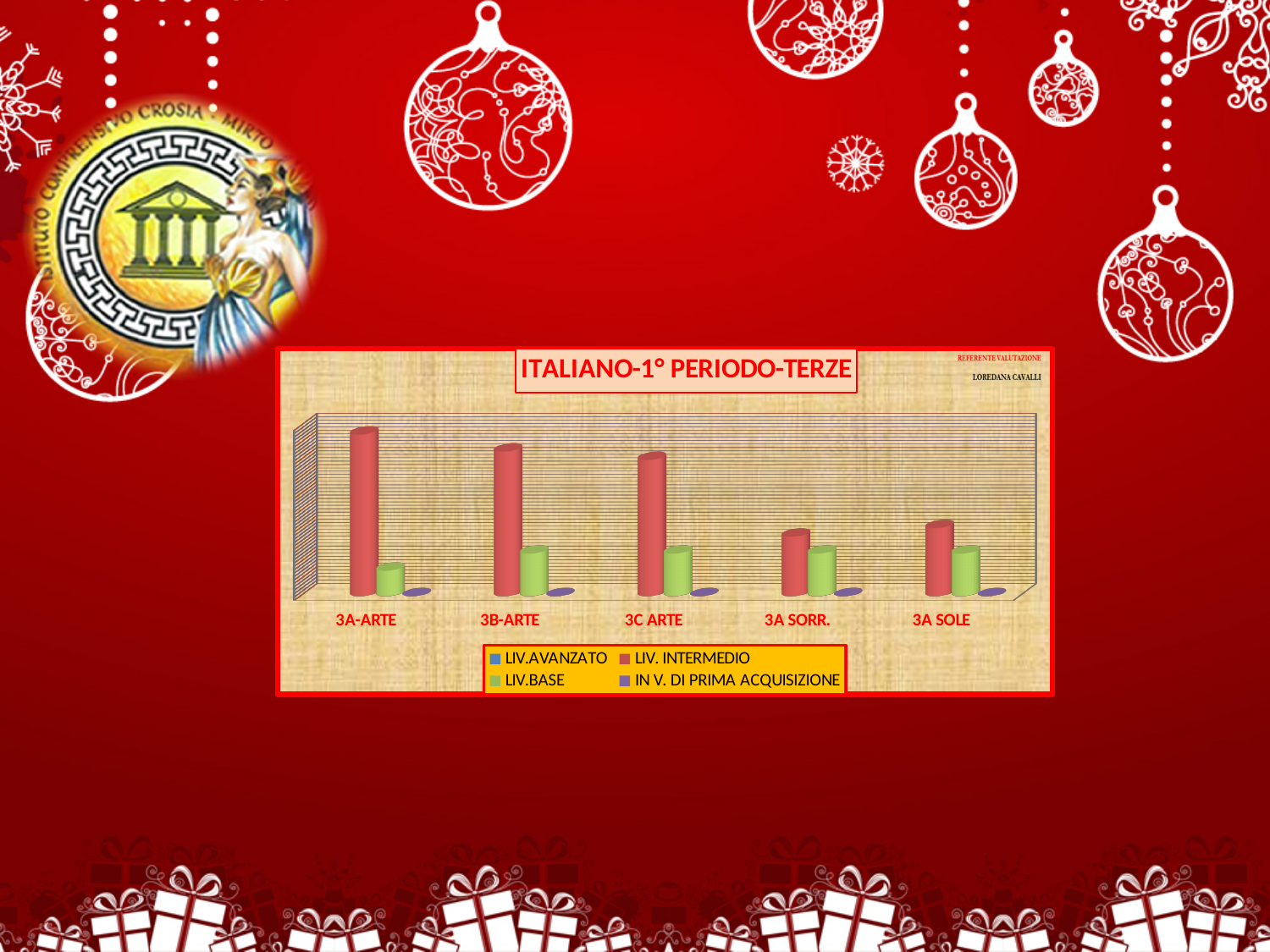
Which class has the larger LIV. INTERMEDIO bar, 3B-ARTE or 3A SOLE? 3B-ARTE Which series is shown in green in the chart legend? LIV.BASE Does the LIV. INTERMEDIO series rise or fall from 3A-ARTE to 3A SORR.? fall How many classes (categories) are shown on the x axis of the chart? 5 Which series has the tallest bar in every class? LIV. INTERMEDIO Which class has the larger LIV. INTERMEDIO bar, 3A-ARTE or 3A SORR.? 3A-ARTE Which class has the lowest LIV.BASE bar? 3A-ARTE Which class has the highest LIV. INTERMEDIO bar? 3A-ARTE What kind of chart is shown on the slide? bar chart How many series does the chart legend list? 4 What is the title of the chart? ITALIANO-1° PERIODO-TERZE For 3A-ARTE, which is larger: LIV. INTERMEDIO or LIV.BASE? LIV. INTERMEDIO